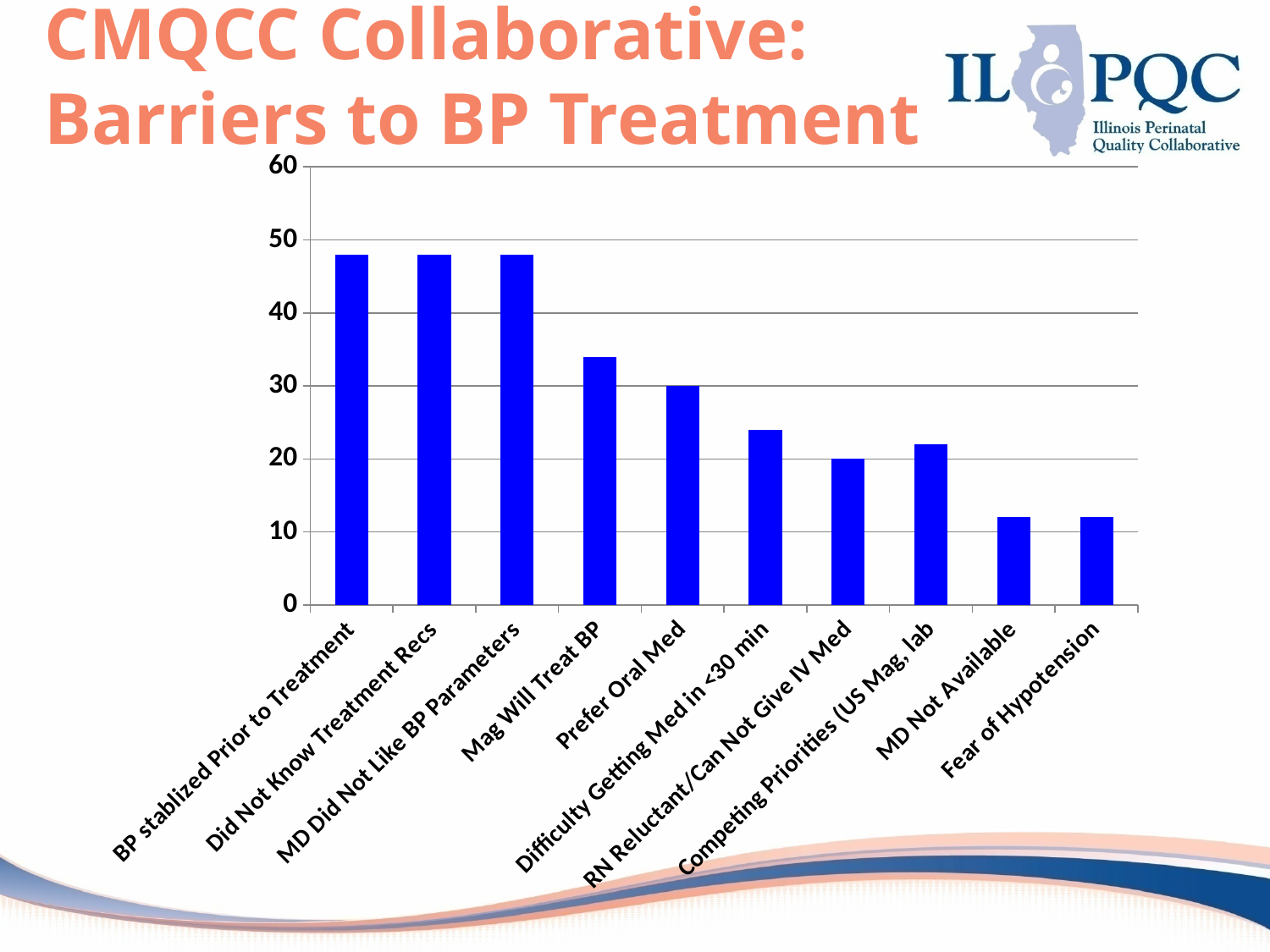
Is the value for "BP stablized Prior to Treatment" greater or less than 40? greater What is the title of the slide containing the chart? CMQCC Collaborative: Barriers to BP Treatment How many barrier categories are plotted on the x axis? 10 Is the value for "MD Not Available" greater or less than 10? greater Do the bar values generally rise or fall moving from left to right along the x axis? fall Is the value for "Competing Priorities (US Mag, lab)" greater or less than 20? greater Which is larger, the value for "Mag Will Treat BP" or the value for "Prefer Oral Med"? Mag Will Treat BP What kind of chart is shown on the slide? Bar chart Which is larger, the value for "Did Not Know Treatment Recs" or the value for "Difficulty Getting Med in <30 min"? Did Not Know Treatment Recs